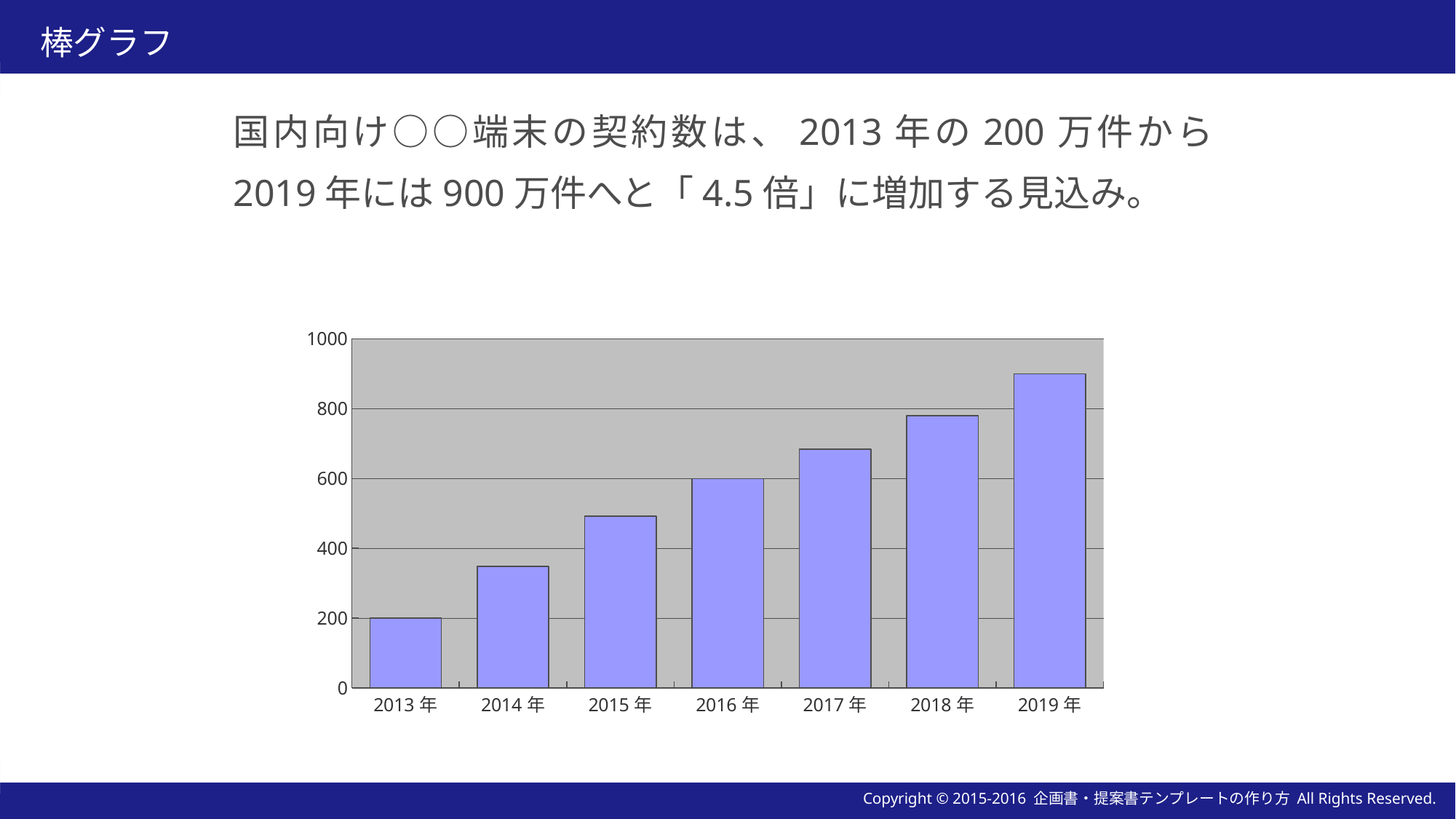
Which year has the lowest bar in the chart? 2013年 Which year has the highest bar in the chart? 2019年 Is the value for 2015年 greater or less than 400? greater How many years (categories) are shown on the x axis of the chart? 7 Is the value for 2018年 greater or less than 600? greater What kind of chart is shown on the slide? bar chart What is the value for 2016年 in the chart? 600 What is the value for 2013年 in the chart? 200 Do the values rise or fall from 2013年 to 2019年 along the x axis? rise Which is larger, the value for 2017年 or the value for 2015年? 2017年 Is the value for 2017年 greater or less than 800? less